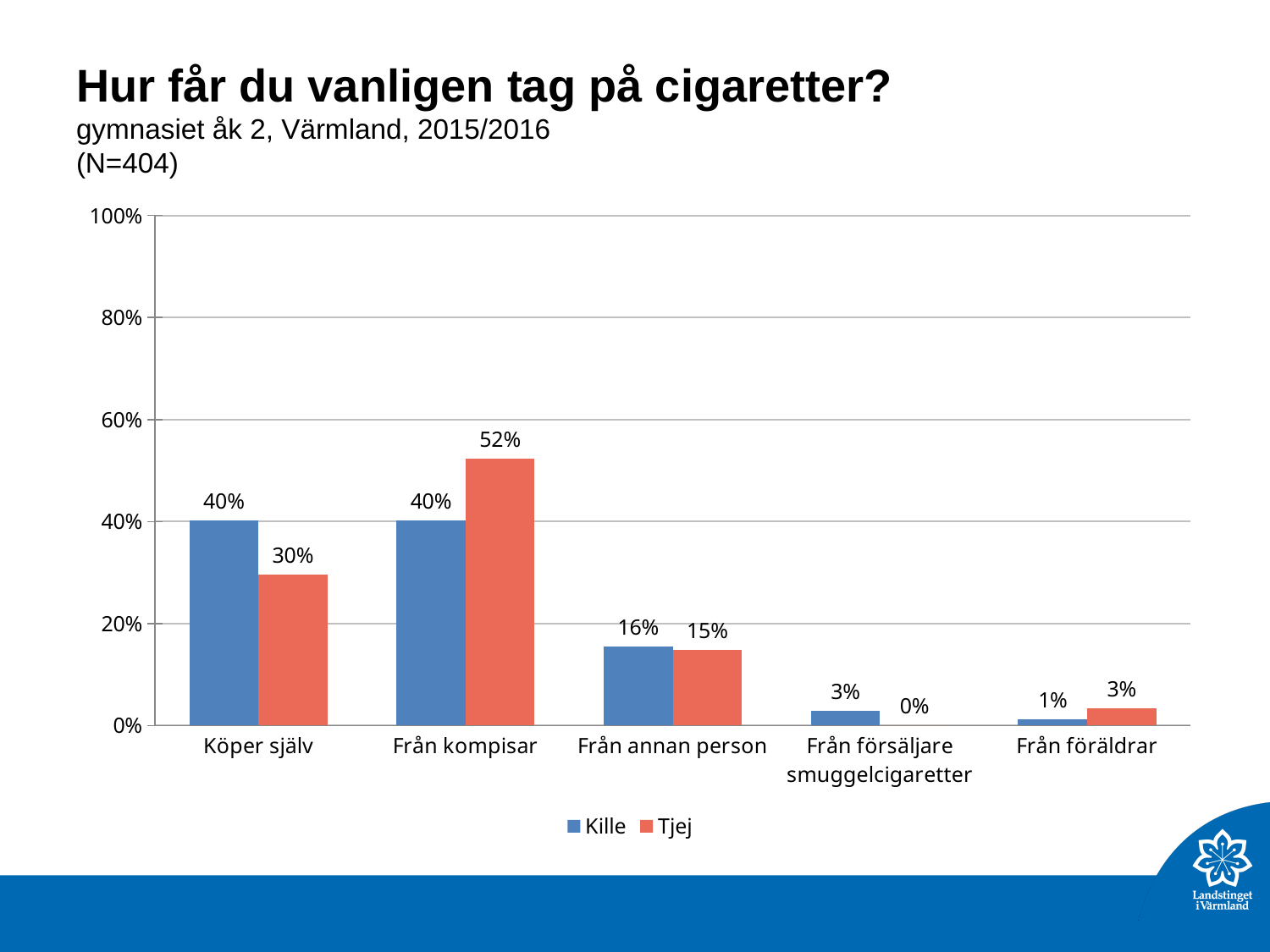
What is the value for Kille in the 'Köper själv' category? 40% What is the difference between the Tjej and Kille values in the 'Från kompisar' category? 12% What is the value for Tjej in the 'Från försäljare smuggelcigaretter' category? 0% How many categories are shown on the x axis? 5 Which is larger in the 'Från föräldrar' category, Kille or Tjej? Tjej What is the value for Tjej in the 'Från kompisar' category? 52% Which category has the highest value for Tjej? Från kompisar Which is larger in the 'Köper själv' category, Kille or Tjej? Kille What is the difference between the Kille and Tjej values in the 'Köper själv' category? 10% Which category has the lowest value for Kille? Från föräldrar How many series does the legend list? 2 What kind of chart is shown on the slide? Bar chart